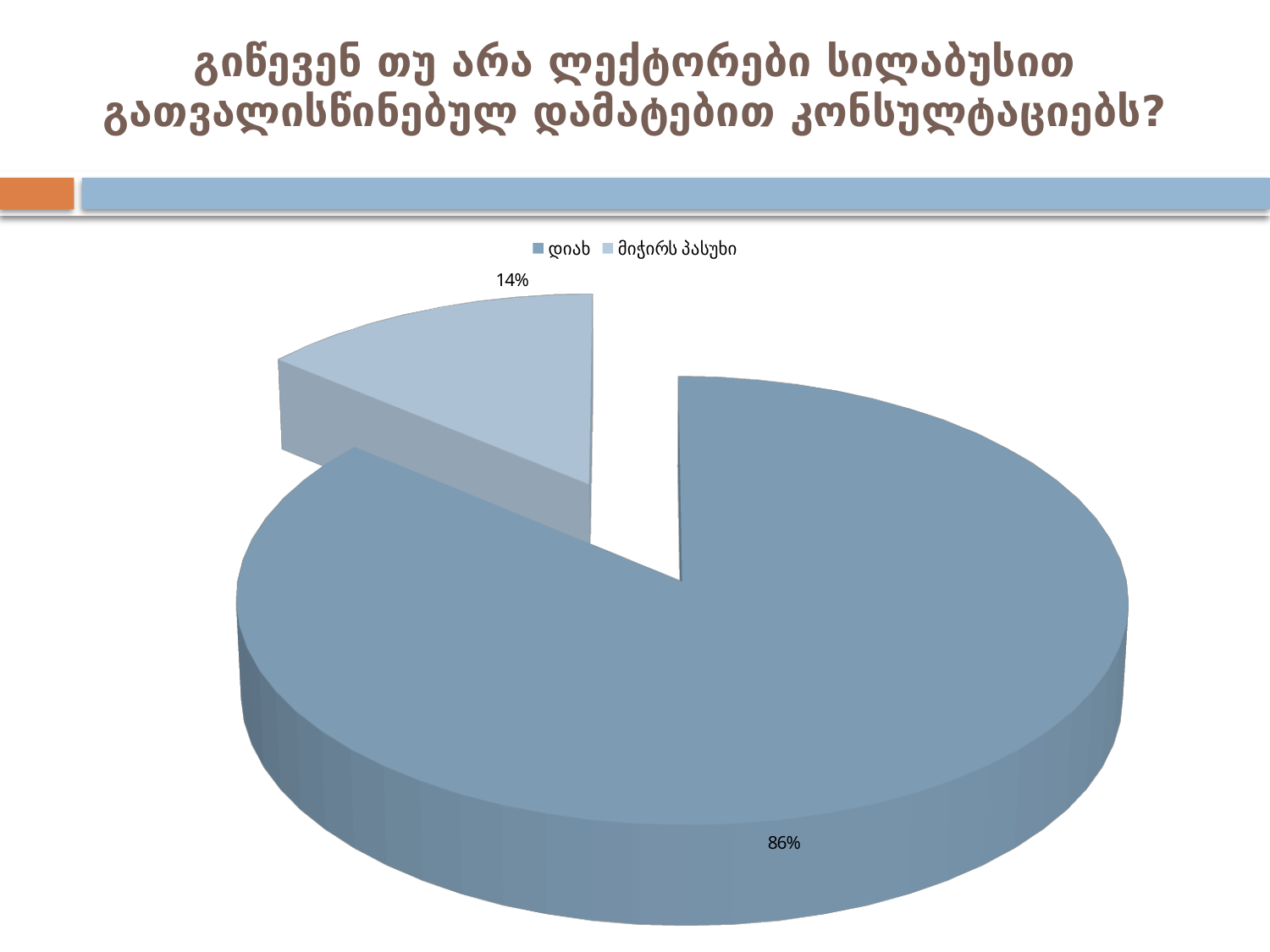
Which slice of the pie is the largest? დიახ What is the difference in percentage points between the "დიახ" slice and the "მიჭირს პასუხი" slice? 72 percentage points Which slice is pulled out (exploded) from the rest of the pie? მიჭირს პასუხი How many slices does the pie chart have? 2 What share of the pie does the "მიჭირს პასუხი" slice represent? 14% Which slice of the pie is the smallest? მიჭირს პასუხი Which legend entry is shown in the lighter blue colour? მიჭირს პასუხი What share of the pie does the "დიახ" slice represent? 86% How many entries does the legend list? 2 Which is larger, the "დიახ" slice or the "მიჭირს პასუხი" slice? დიახ What is the total of the two slices shown in the pie chart? 100% What kind of chart is shown on the slide? pie chart